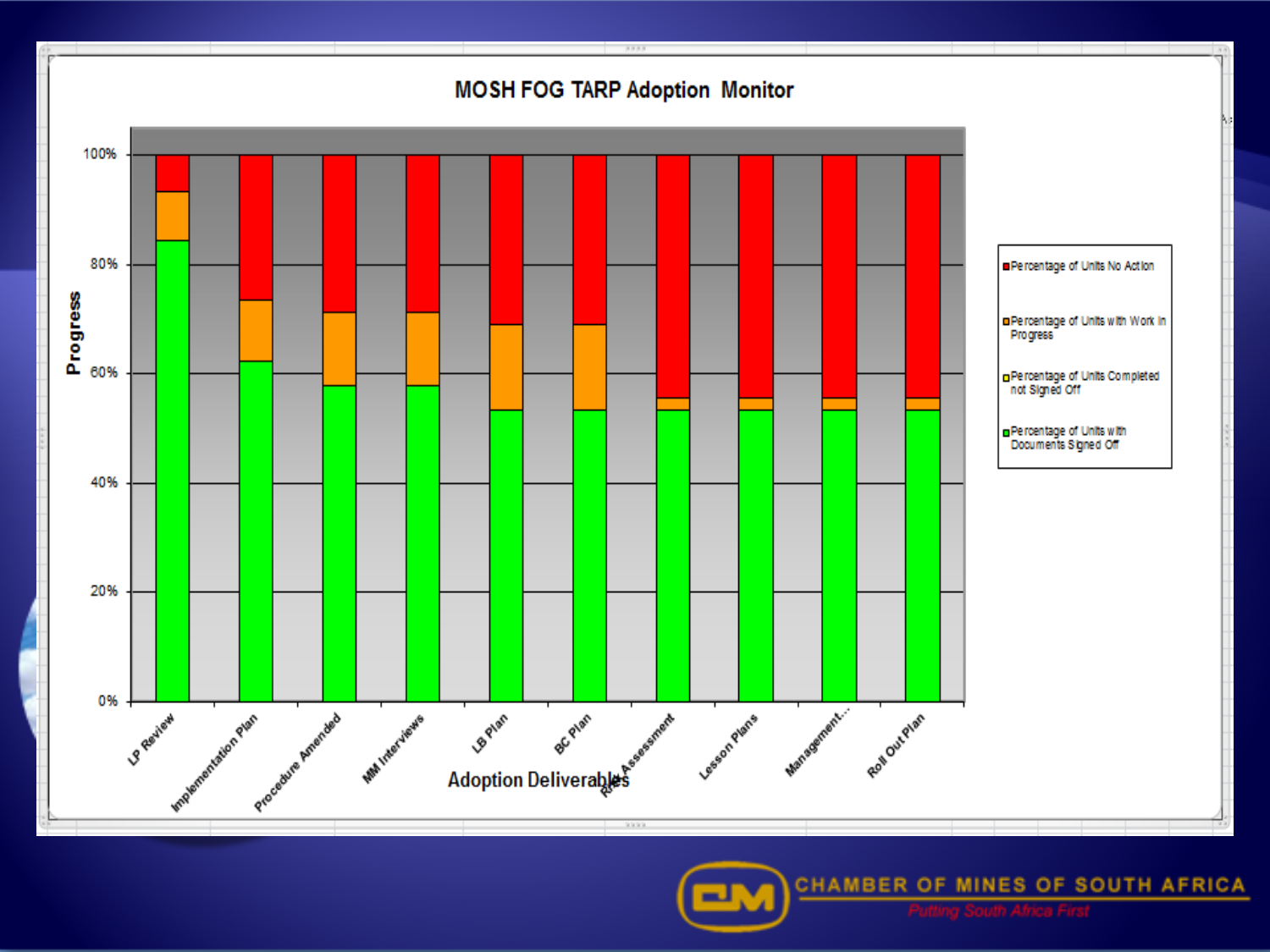
Is the Percentage of Units with Documents Signed Off for Roll Out Plan greater or less than 60%? less Moving from LP Review to Roll Out Plan along the x axis, does the Percentage of Units with Documents Signed Off rise or fall? fall Is the Percentage of Units with Documents Signed Off for LP Review greater or less than 80%? greater What kind of chart is shown on the slide? Stacked bar chart Is the Percentage of Units No Action for LP Review greater or less than 20%? less How many series does the legend list? 4 What is the total height of the stacked bar for Implementation Plan? 100% How many adoption deliverables (categories) are plotted on the x axis? 10 Which adoption deliverable has the highest Percentage of Units with Documents Signed Off? LP Review Which has a larger Percentage of Units with Documents Signed Off: LP Review or Roll Out Plan? LP Review What is the title of the chart? MOSH FOG TARP Adoption Monitor